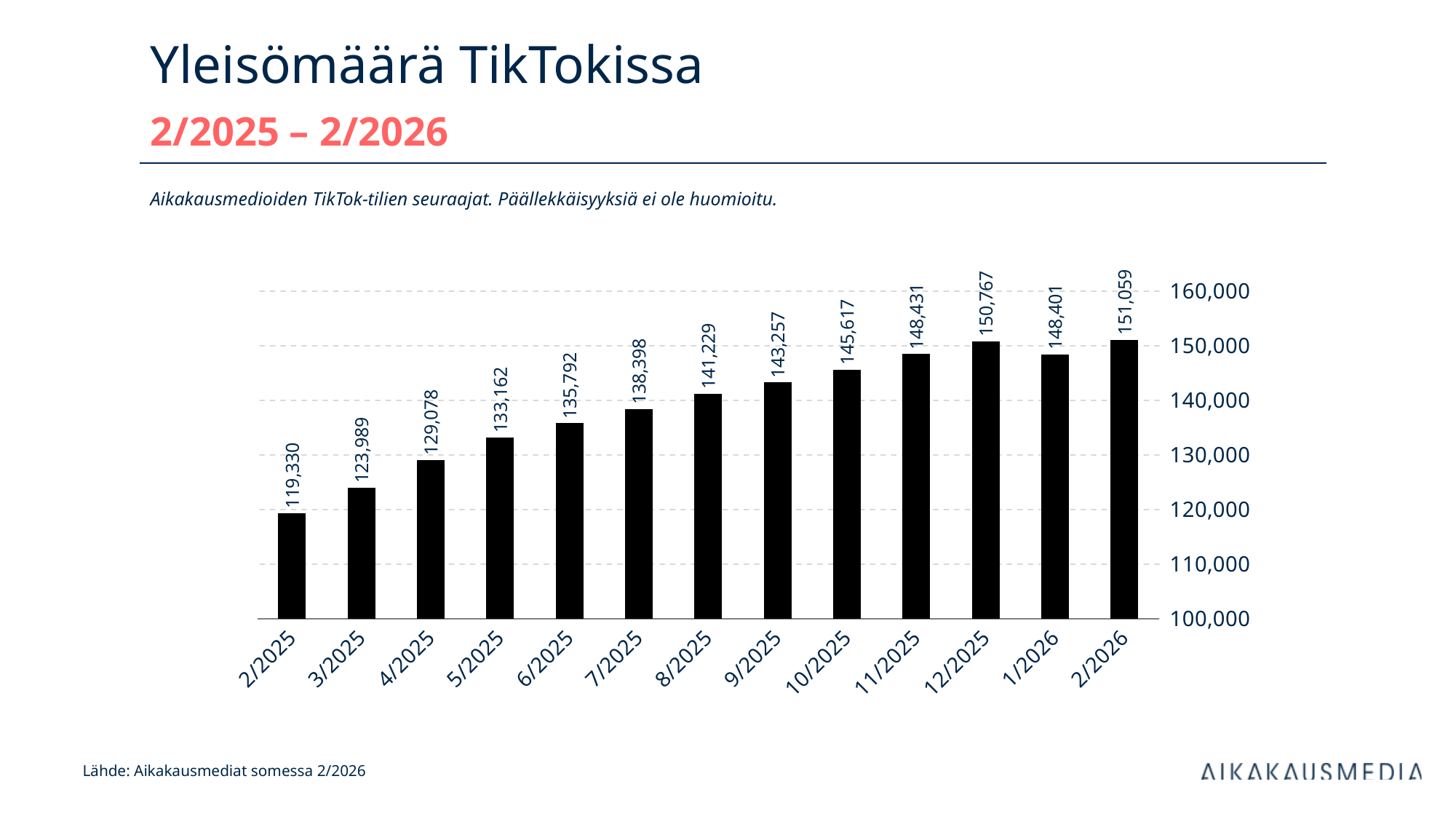
How many months are shown on the x axis? 13 What is the value for 12/2025? 150,767 Do the values generally rise or fall from 2/2025 to 2/2026? rise What is the difference between the values for 2/2026 and 2/2025? 31,729 What is the value for 2/2025? 119,330 Which is larger, the value for 12/2025 or the value for 1/2026? 12/2025 Is the value for 7/2025 greater or less than 140,000? less Which month has the highest value? 2/2026 What is the difference between the values for 12/2025 and 1/2026? 2,366 Which month has the lowest value? 2/2025 What kind of chart is shown on the slide? bar chart What is the value for 1/2026? 148,401